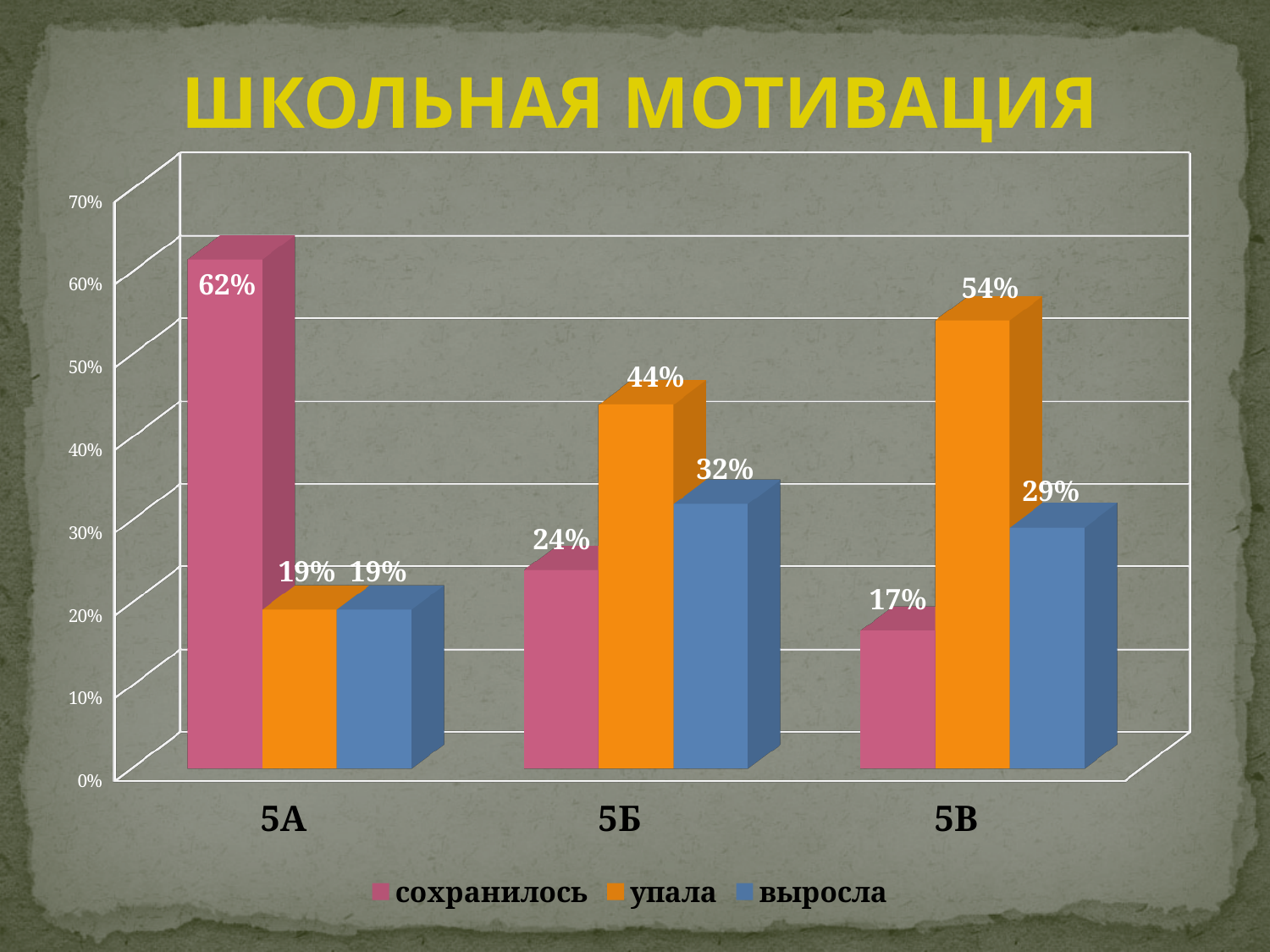
How many series does the legend list? 3 How does the value for "сохранилось" change from 5А to 5В? falls Which is larger in class 5Б: "упала" or "выросла"? упала Which class has the highest value for "упала"? 5В What is the title of the slide? ШКОЛЬНАЯ МОТИВАЦИЯ What kind of chart is shown on the slide? bar chart What is the value for "сохранилось" in class 5А? 62% How many classes are shown on the x axis? 3 What is the value for "упала" in class 5Б? 44% Which class has the lowest value for "сохранилось"? 5В What is the value for "выросла" in class 5В? 29% What is the difference between "упала" and "сохранилось" in class 5В? 37%